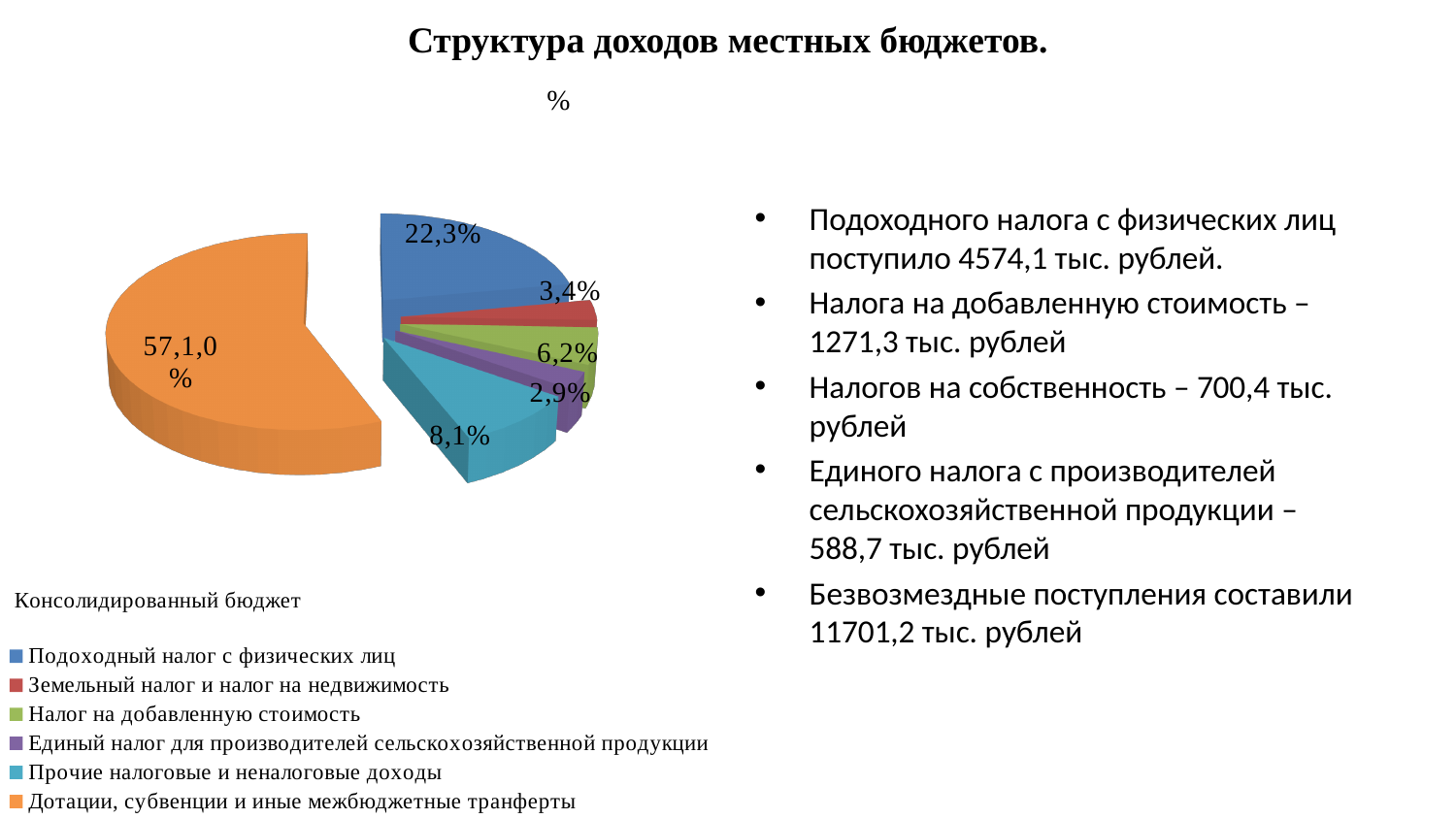
What share of the pie does 'Налог на добавленную стоимость' have? 6,2% Which is larger: the share for 'Прочие налоговые и неналоговые доходы' or for 'Налог на добавленную стоимость'? Прочие налоговые и неналоговые доходы What is the difference in percentage points between the shares of 'Подоходный налог с физических лиц' and 'Прочие налоговые и неналоговые доходы'? 14,2 What share of the pie does 'Земельный налог и налог на недвижимость' have? 3,4% What share of the pie does 'Единый налог для производителей сельскохозяйственной продукции' have? 2,9% Which category has the largest slice of the pie? Дотации, субвенции и иные межбюджетные транферты How many categories does the legend of the pie chart list? 6 What share of the pie does 'Прочие налоговые и неналоговые доходы' have? 8,1% Which category has the smallest slice of the pie? Единый налог для производителей сельскохозяйственной продукции What kind of chart is shown on the slide? pie chart What colour is the slice for 'Дотации, субвенции и иные межбюджетные трансферты'? orange What share of the pie does 'Подоходный налог с физических лиц' have? 22,3%